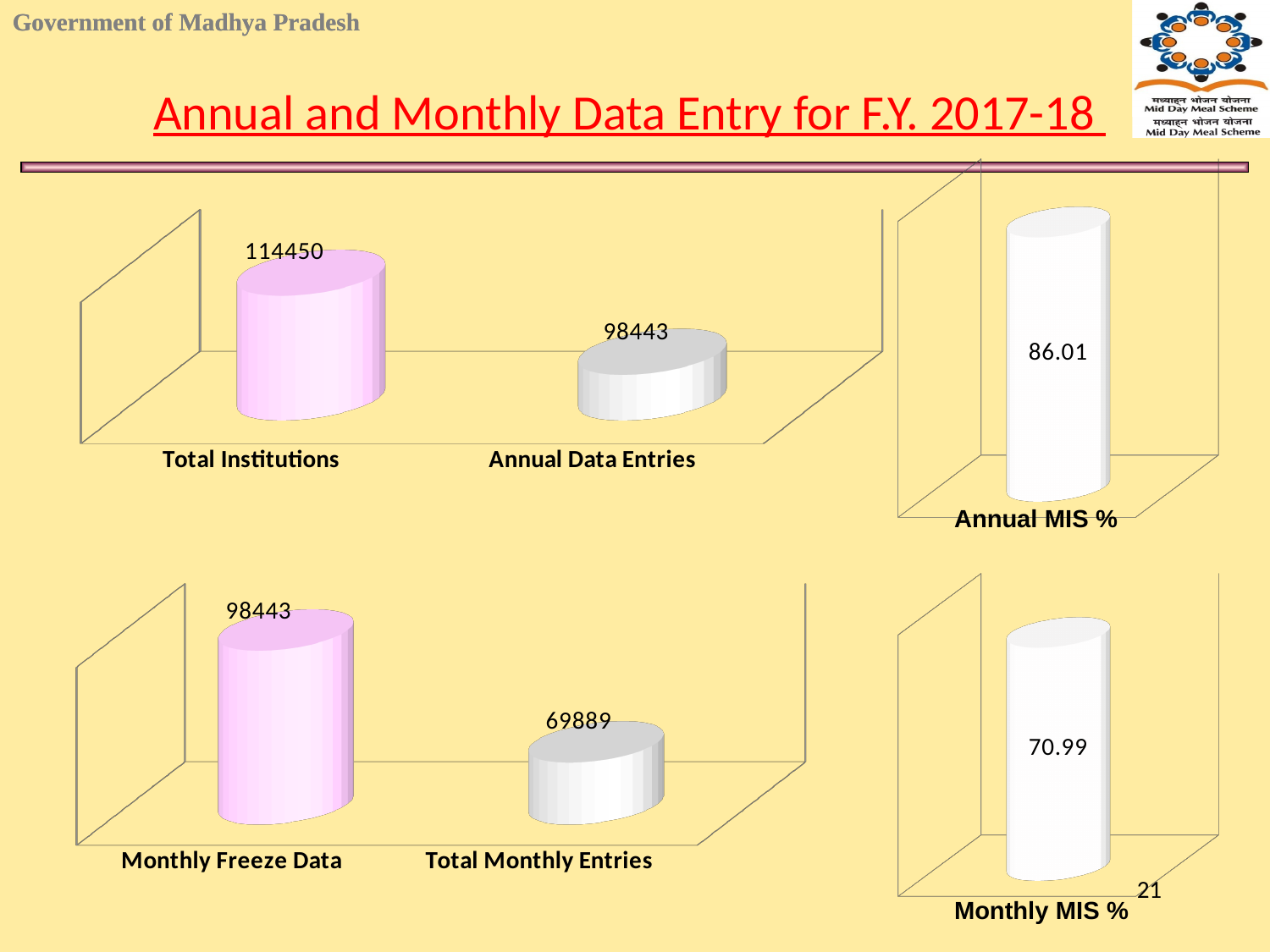
In the bottom-left chart, which category has the lower value? Total Monthly Entries In the top-left chart, which category has the higher value? Total Institutions In the bottom-right chart, what is the value shown for Monthly MIS %? 70.99 In the top-left chart, what is the value for Annual Data Entries? 98443 In the top-right chart, what is the value shown for Annual MIS %? 86.01 In the top-left chart, what is the difference between Total Institutions and Annual Data Entries? 16007 How many categories are plotted in the bottom-left chart? 2 In the bottom-left chart, what is the value for Total Monthly Entries? 69889 In the top-left chart, what is the value for Total Institutions? 114450 In the bottom-left chart, what is the difference between Monthly Freeze Data and Total Monthly Entries? 28554 Which is larger: the Annual MIS % in the top-right chart or the Monthly MIS % in the bottom-right chart? Annual MIS % In the bottom-left chart, what is the value for Monthly Freeze Data? 98443